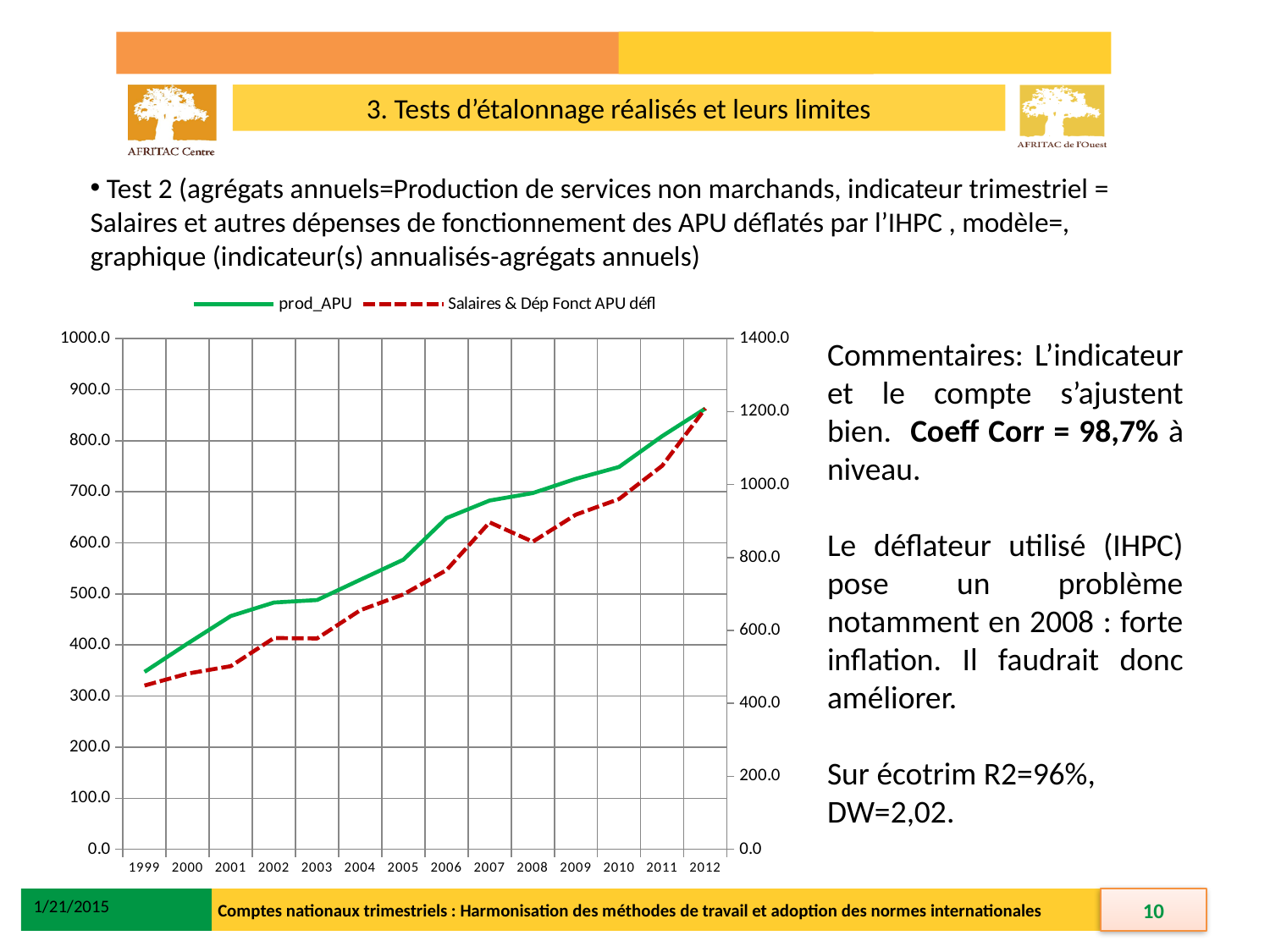
Do the values of the prod_APU line generally rise or fall from 1999 to 2012? rise Read against the left-hand axis, is the prod_APU value in 1999 greater or less than 400? less What kind of chart is shown on the slide? line chart Which is larger for the prod_APU line: the value in 2012 or the value in 1999? 2012 In which year is the prod_APU line at its lowest value? 1999 How many years are plotted along the x axis of the chart? 14 How many series does the chart legend list? 2 Read against the left-hand axis, is the prod_APU value in 2012 greater or less than 800? greater What is the last year shown on the x axis of the chart? 2012 In which year does the prod_APU line reach its highest value? 2012 What is the first year shown on the x axis of the chart? 1999 Do the values of the Salaires & Dép Fonct APU défl line generally rise or fall from 1999 to 2012? rise